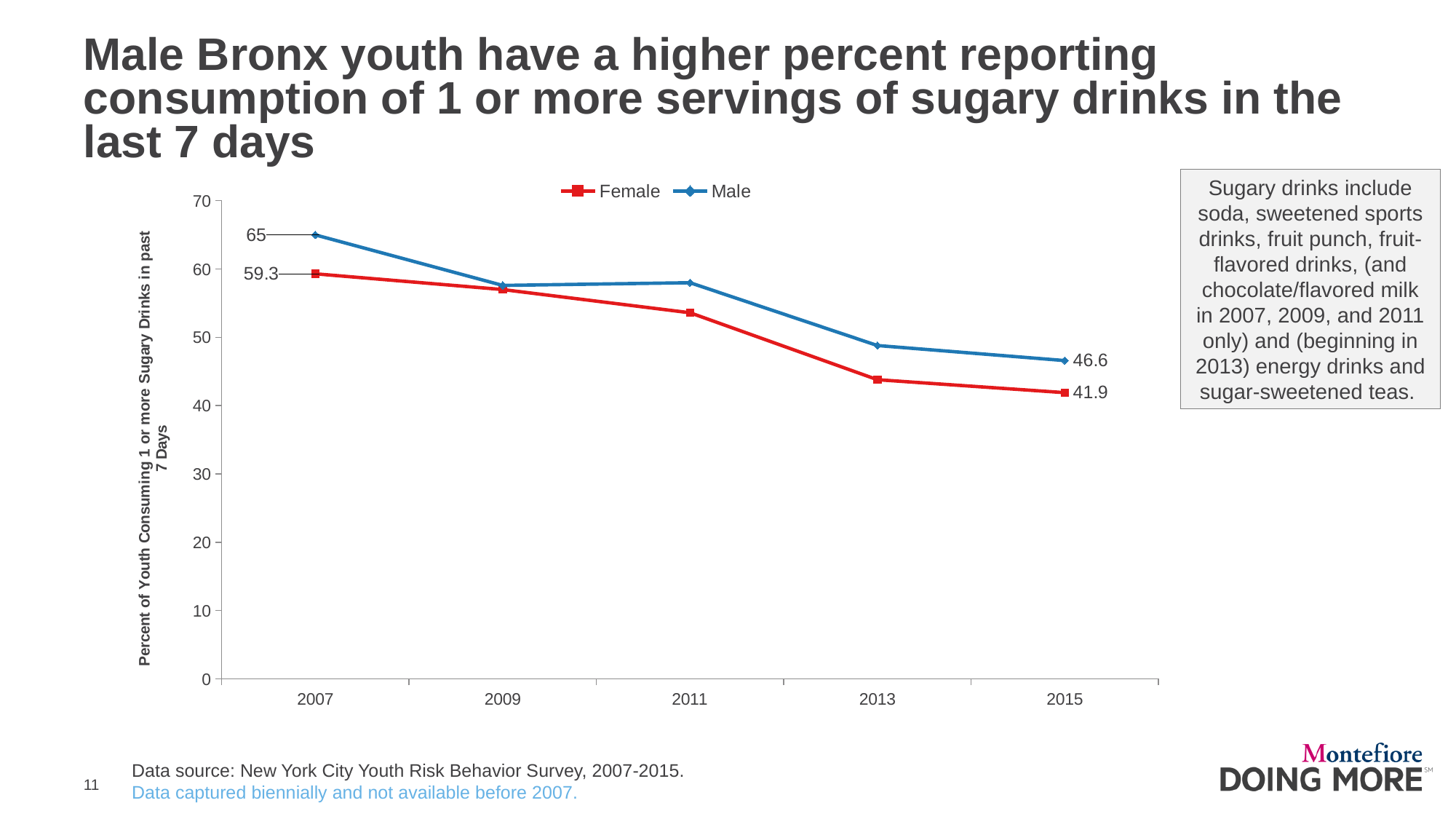
What kind of chart is shown on the slide? line chart What is the difference between the Male and Female values in 2015? 4.7 What is the value for Female in 2015? 41.9 In 2007, which series has the higher value, Male or Female? Male By how much did the Male value decrease from 2007 to 2015? 18.4 What is the value for Female in 2007? 59.3 What is the value for Male in 2015? 46.6 What is the value for Male in 2007? 65 How many series does the legend list? 2 How many years are shown on the x axis? 5 Do the Female values rise or fall from 2007 to 2015? fall Is the value for Female in 2013 greater or less than 50? less